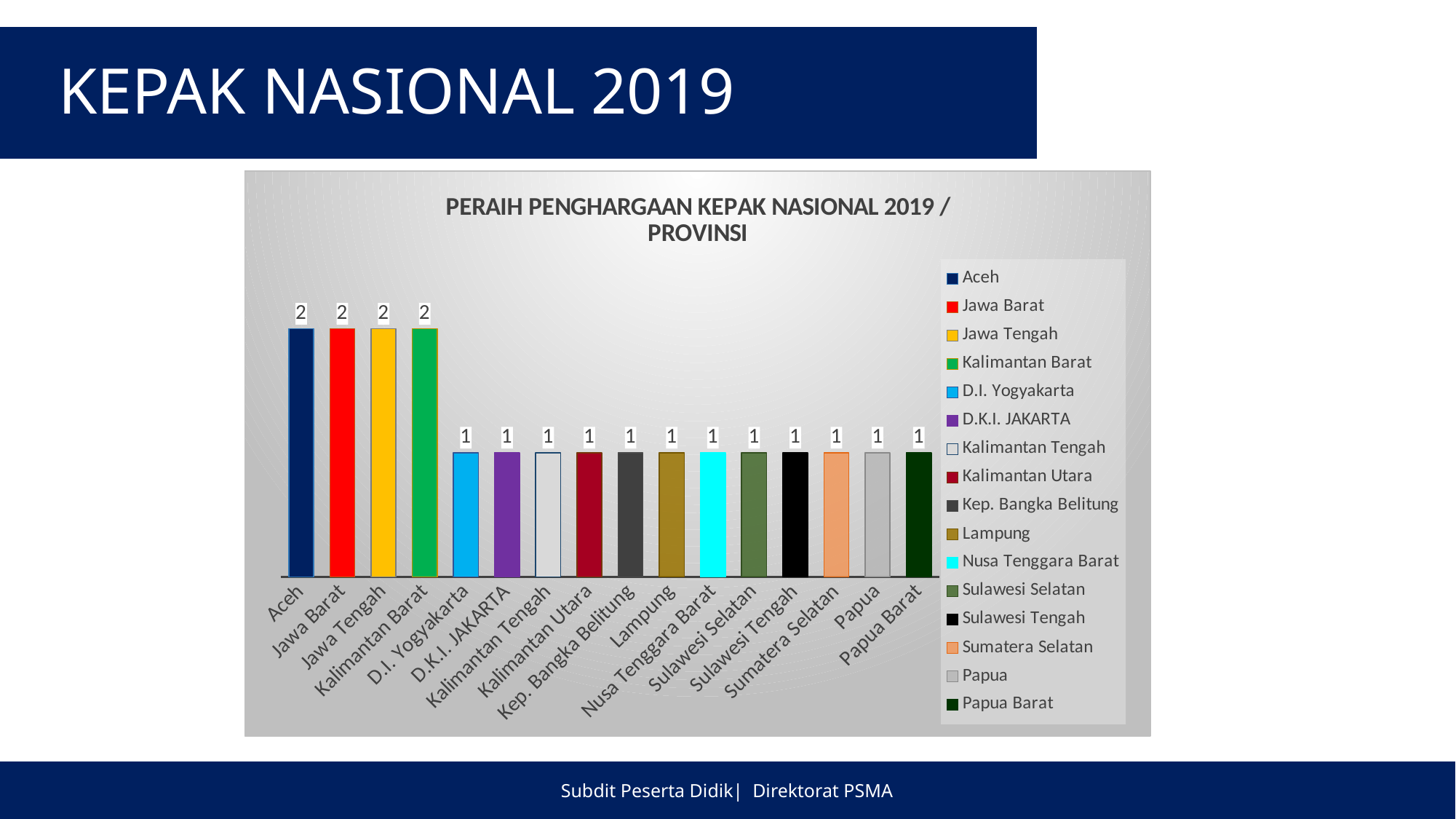
How many provinces are shown on the x axis? 16 What is the title of the chart? PERAIH PENGHARGAAN KEPAK NASIONAL 2019 / PROVINSI Which is larger, the value for Jawa Tengah or the value for Sulawesi Selatan? Jawa Tengah What is the value for Aceh? 2 How many provinces have a value of 2? 4 What is the value for Lampung? 1 What colour is the bar for Jawa Barat? red What is the value for Kalimantan Barat? 2 What is the value for Papua Barat? 1 How many entries does the legend list? 16 What kind of chart is shown? bar chart What is the difference between the value for Jawa Barat and the value for Papua? 1